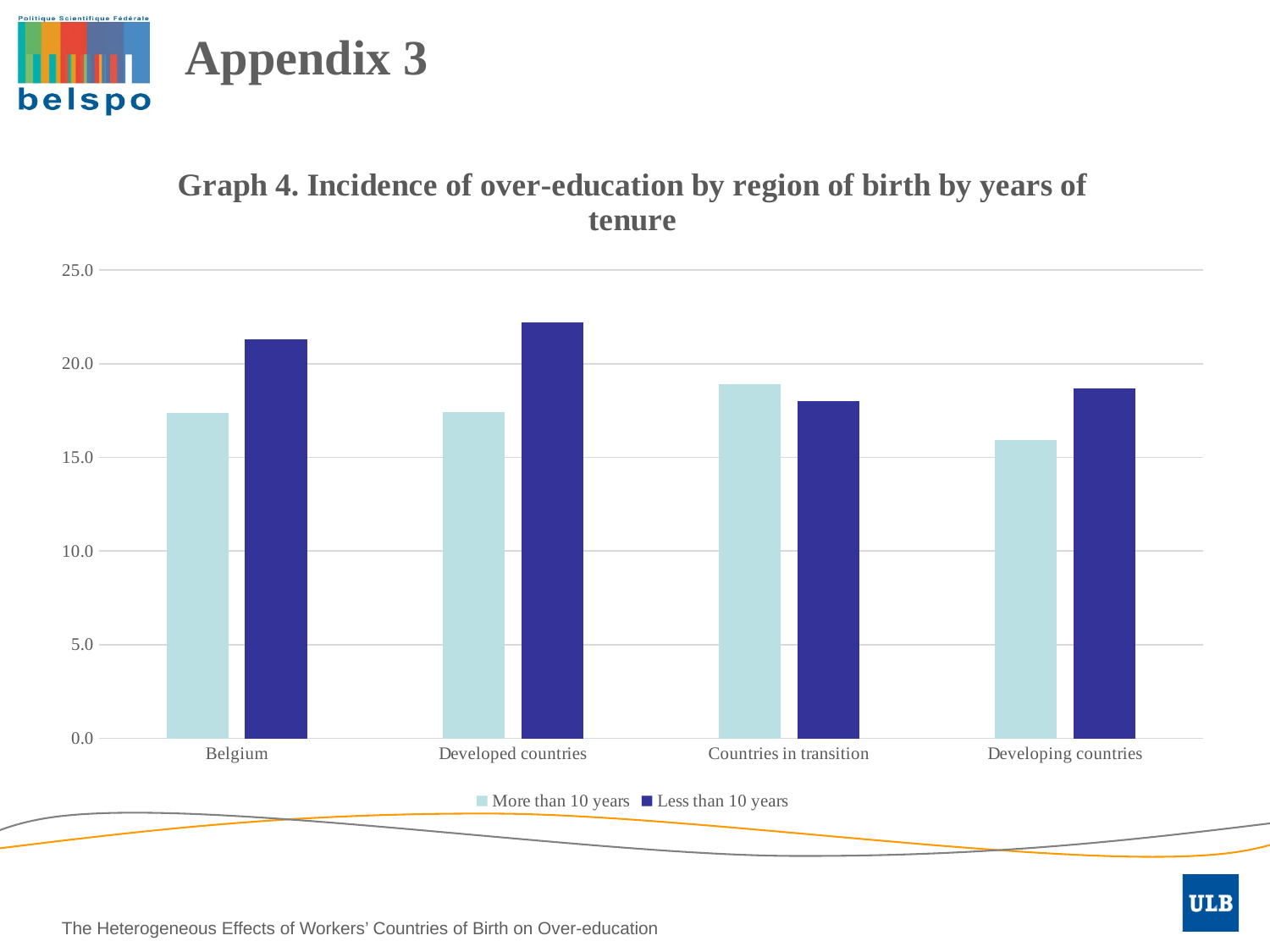
Which region has the highest value in the 'More than 10 years' series? Countries in transition Which series is shown in dark blue? Less than 10 years What is the title of the chart? Graph 4. Incidence of over-education by region of birth by years of tenure Is the value for Countries in transition in the 'More than 10 years' series greater or less than 20.0? less How many regions of birth are shown on the x axis? 4 Is the value for Developing countries in the 'More than 10 years' series greater or less than 15.0? greater How many series does the legend list? 2 What kind of chart is shown on the slide? bar chart Which region has the lowest value in the 'More than 10 years' series? Developing countries Which region has the highest value in the 'Less than 10 years' series? Developed countries For Belgium, which is larger: the 'More than 10 years' value or the 'Less than 10 years' value? Less than 10 years Is the value for Belgium in the 'Less than 10 years' series greater or less than 20.0? greater